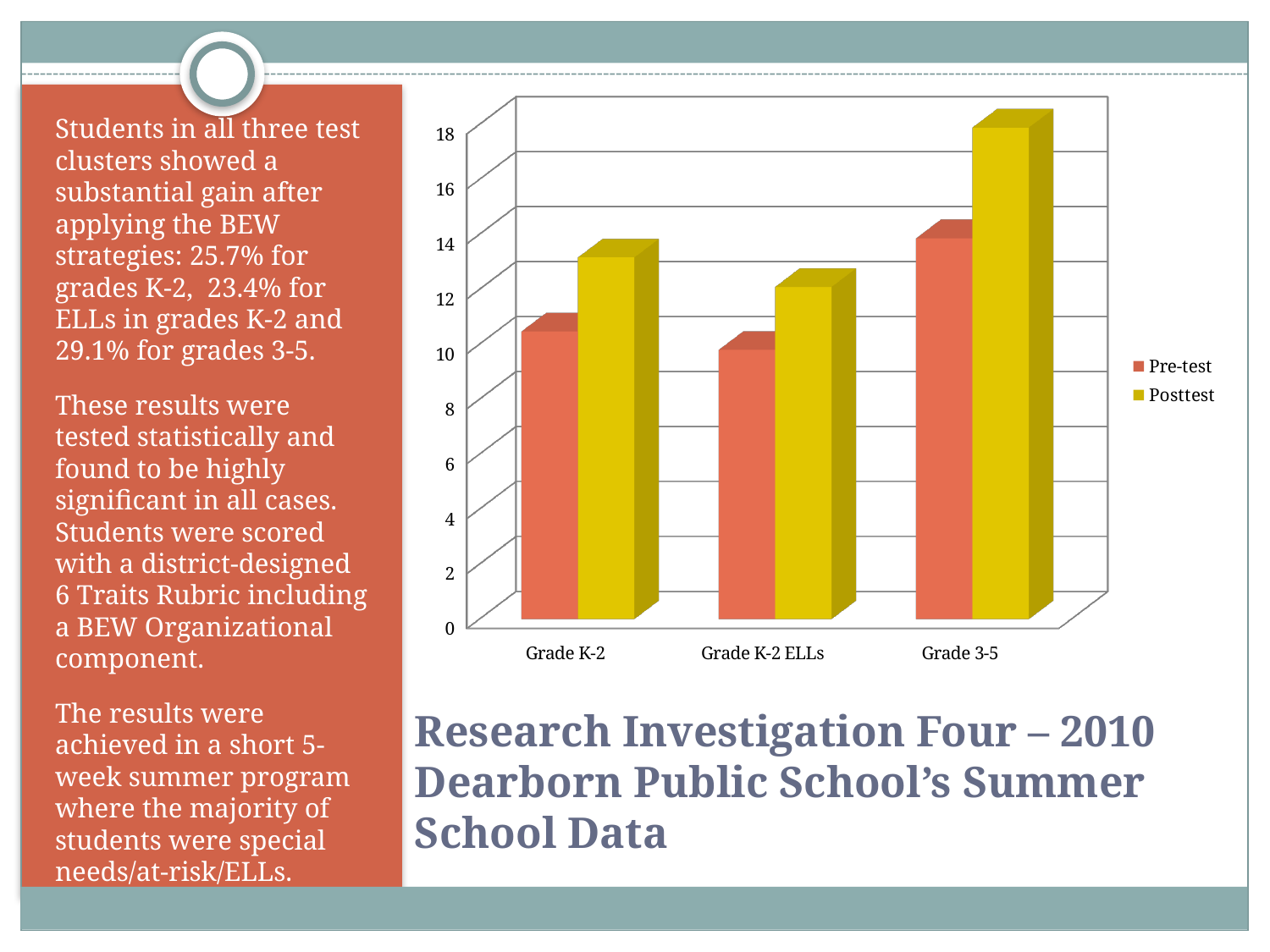
Which category has the highest Pre-test value? Grade 3-5 Is the Posttest value for Grade K-2 greater or less than 12? greater Is the Posttest value for Grade 3-5 greater or less than 16? greater Is the Pre-test value for Grade K-2 ELLs greater or less than 12? less What kind of chart is shown on the slide? bar chart How many series does the chart's legend list? 2 What are the two series named in the chart's legend? Pre-test and Posttest How many categories are shown on the x axis of the chart? 3 Which category has the highest Posttest value? Grade 3-5 For Grade K-2, which is larger, the Pre-test or the Posttest value? Posttest Which category has the lowest Posttest value? Grade K-2 ELLs